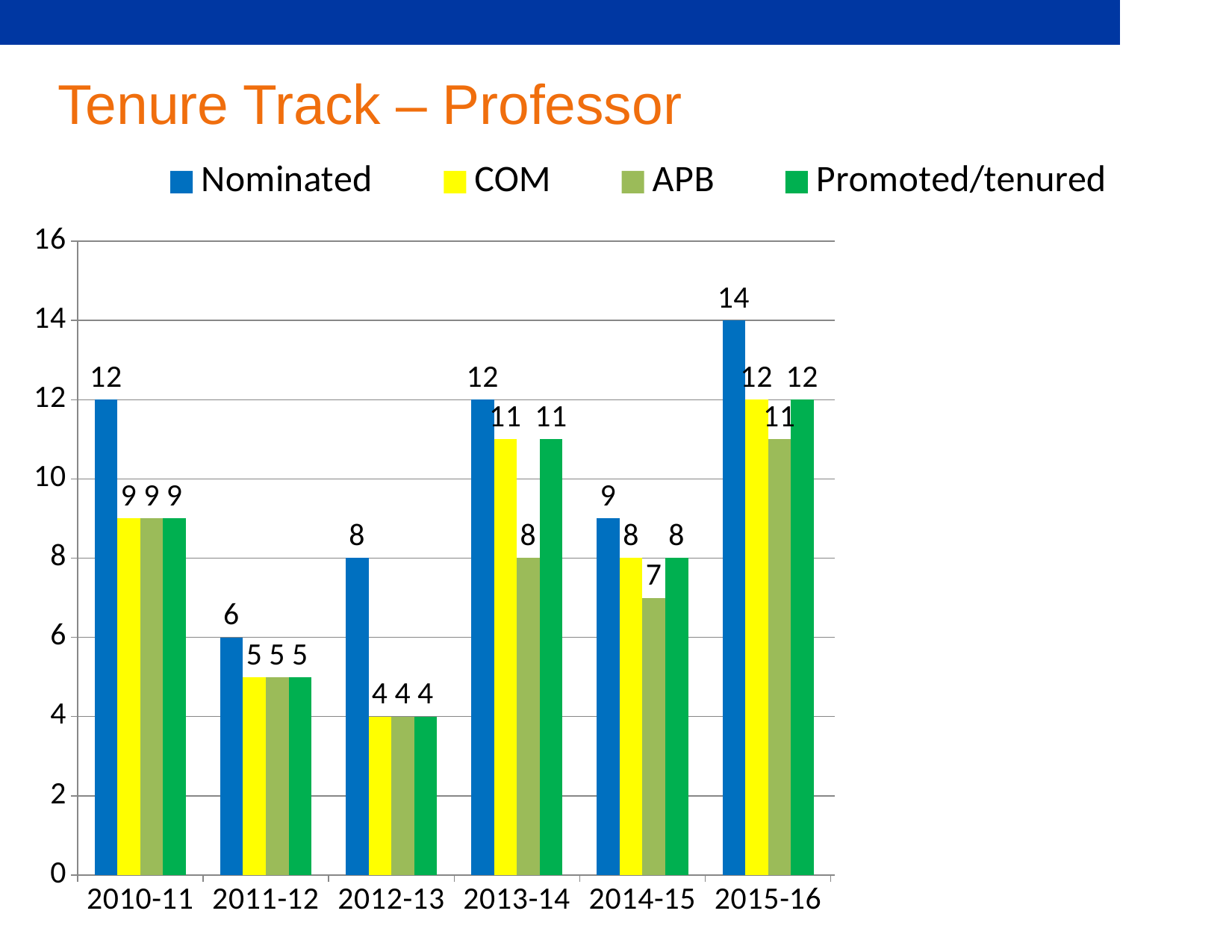
Which year has the lowest Promoted/tenured value? 2012-13 How many years are shown on the x axis? 6 What is the COM value for 2013-14? 11 What is the difference between the Nominated and Promoted/tenured values in 2012-13? 4 What is the Nominated value for 2015-16? 14 Which series is shown in yellow? COM How many series does the legend list? 4 What is the title of the slide? Tenure Track – Professor Which is larger in 2014-15, the COM value or the APB value? COM Which year has the highest Nominated value? 2015-16 What is the APB value for 2014-15? 7 What kind of chart is shown on the slide? Bar chart